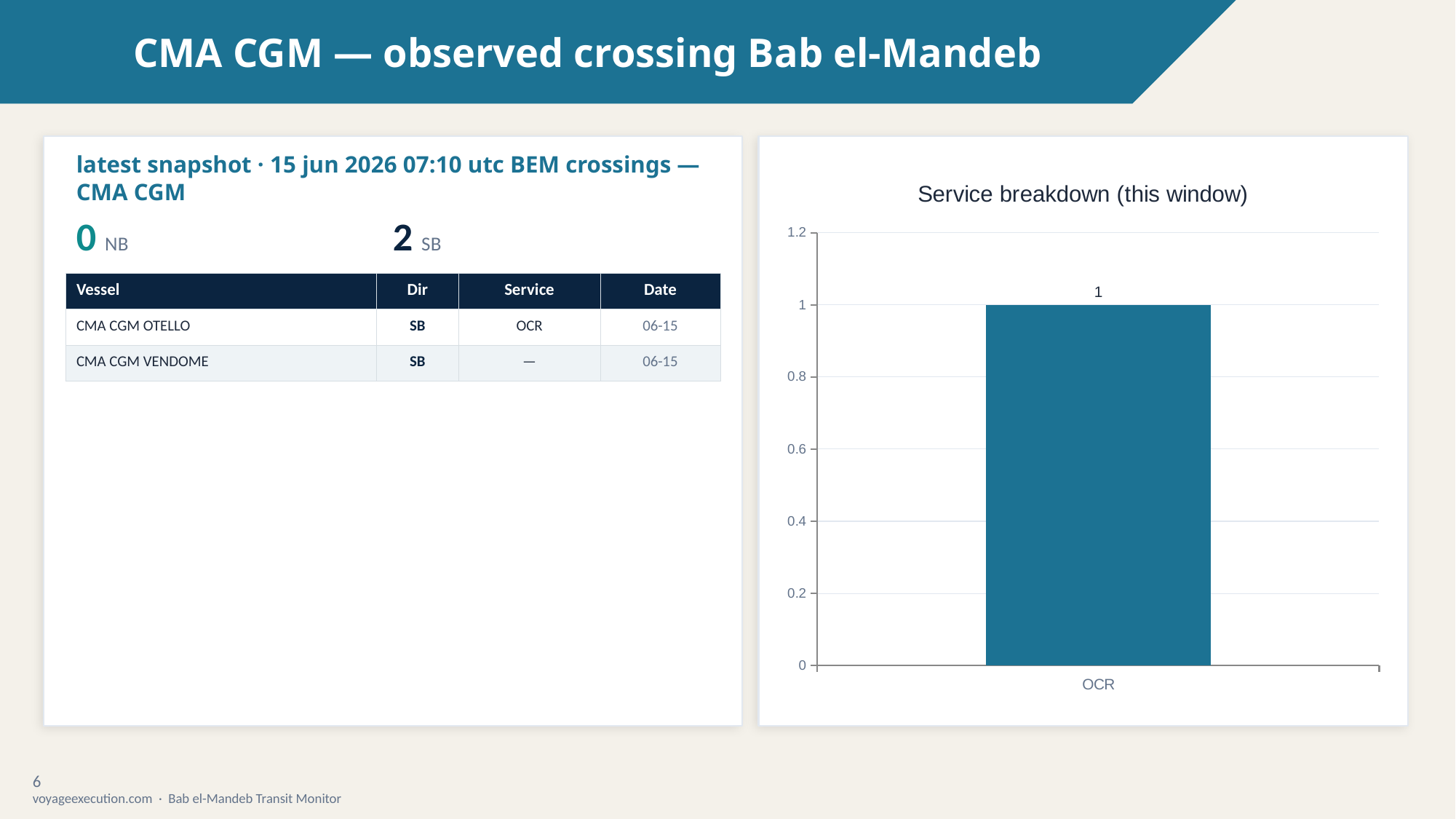
What is the title of the chart on the right of the slide? Service breakdown (this window) Is the value for OCR in the Service breakdown chart greater or less than 0.8? greater What is the value for OCR in the Service breakdown chart? 1 What kind of chart is the Service breakdown chart? bar chart Is the value for OCR in the Service breakdown chart greater or less than 1.2? less How many categories are plotted in the Service breakdown chart? 1 What is the label of the only category on the x axis of the Service breakdown chart? OCR What is the highest value shown on the y axis of the Service breakdown chart? 1.2